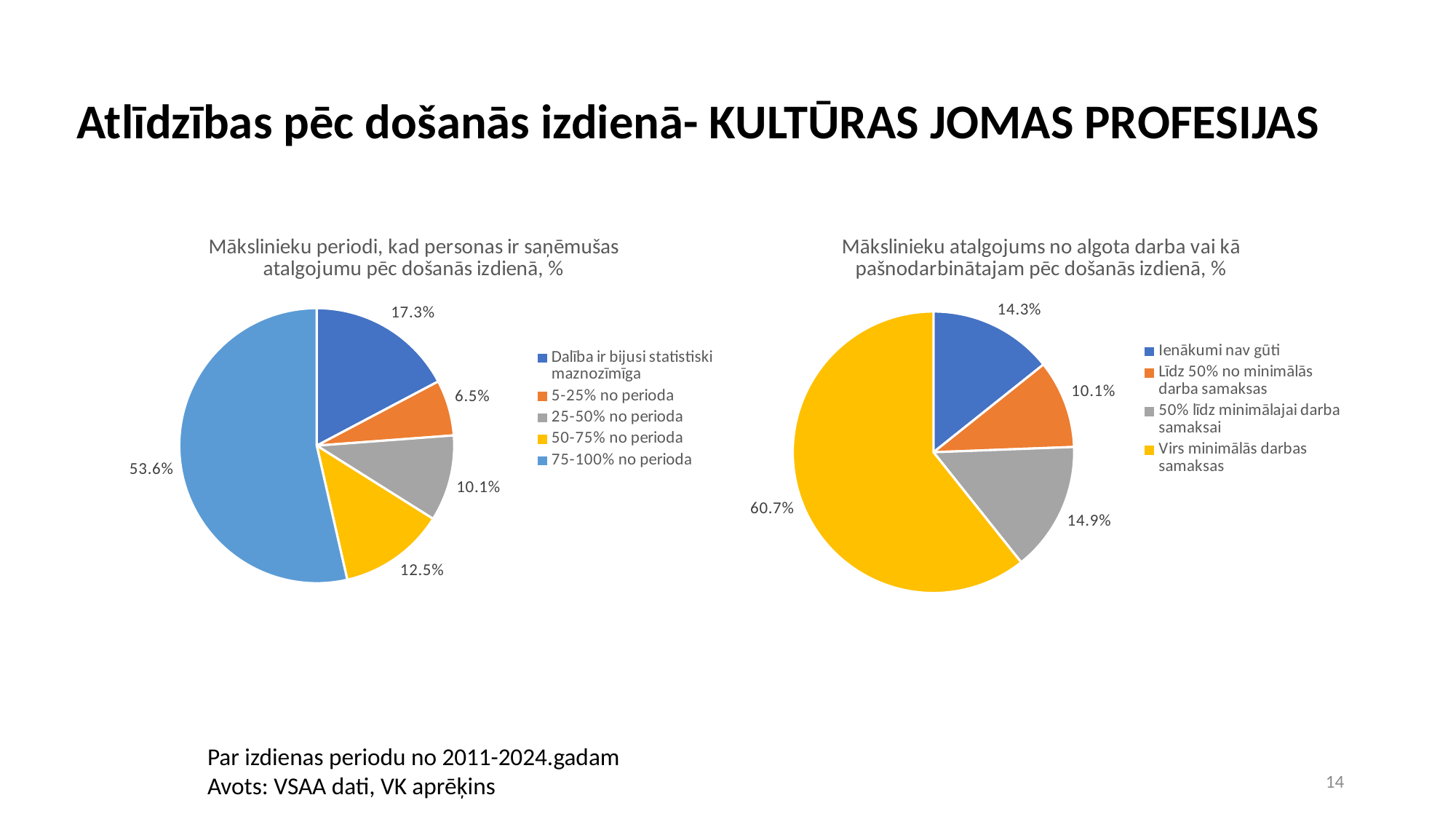
In the right pie chart, which is larger: 'Ienākumi nav gūti' or '50% līdz minimālajai darba samaksai'? 50% līdz minimālajai darba samaksai In the left pie chart, which category has the largest slice? 75-100% no perioda In the left pie chart, which category has the smallest slice? 5-25% no perioda In the right pie chart, what share is shown for 'Virs minimālās darbas samaksas'? 60.7% In the left pie chart, what share is shown for '75-100% no perioda'? 53.6% How many slices does the left pie chart have? 5 How many categories does the legend of the right pie chart list? 4 In the right pie chart, what share is shown for 'Ienākumi nav gūti'? 14.3% In the left pie chart, what share is shown for '5-25% no perioda'? 6.5% In the right pie chart, which category has the smallest slice? Līdz 50% no minimālās darba samaksas In the left pie chart, what is the difference between the shares for '50-75% no perioda' and '25-50% no perioda'? 2.4% What type of chart is used on the right side of the slide? Pie chart